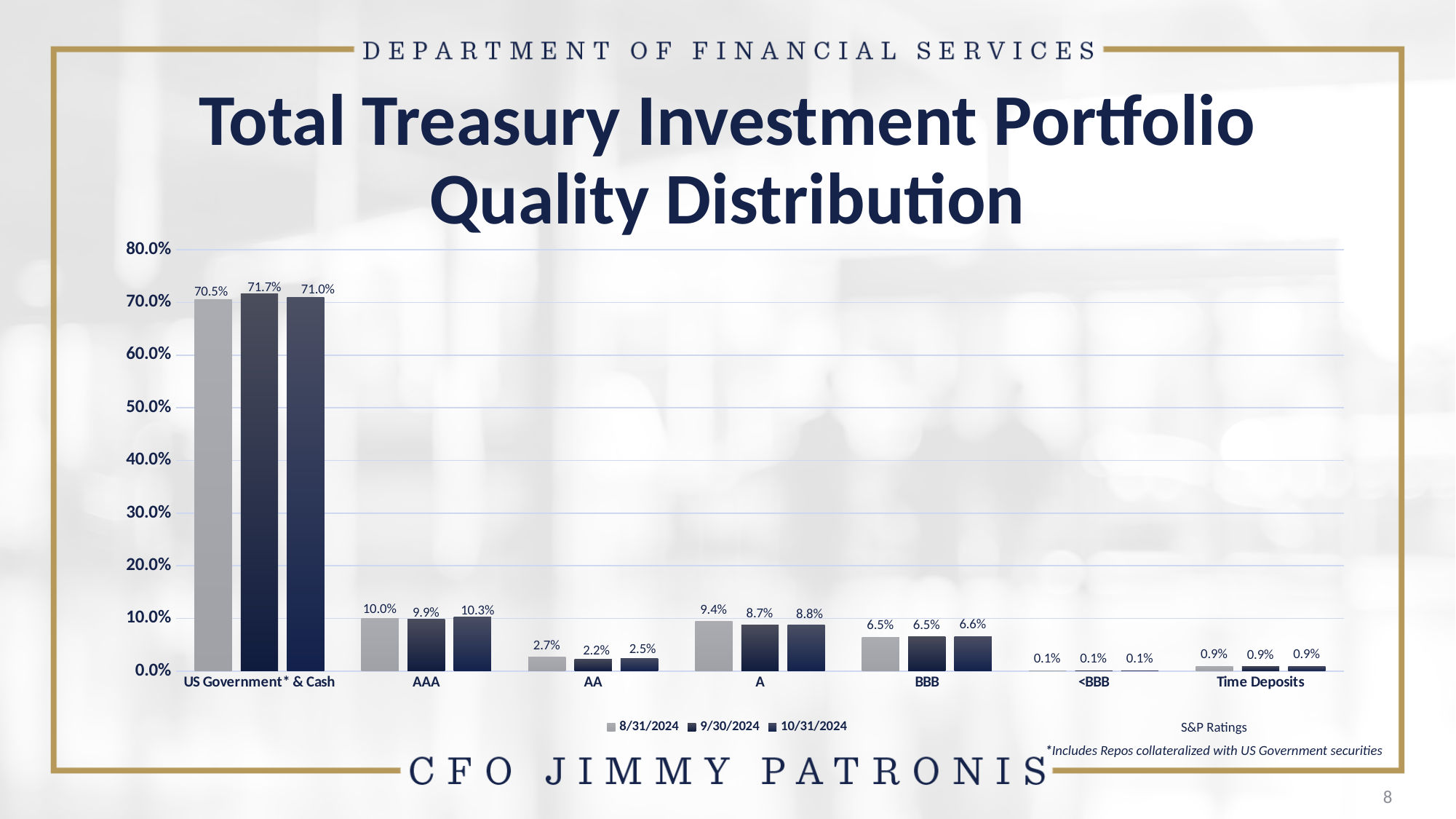
How many series does the legend list? 3 What is the value for AA in the 8/31/2024 series? 2.7% Which is larger: the 8/31/2024 value for A or the 8/31/2024 value for BBB? A Which category has the lowest value in the 10/31/2024 series? <BBB What is the value for US Government* & Cash in the 9/30/2024 series? 71.7% What kind of chart is shown on the slide? Bar chart Which category has the highest value in the 8/31/2024 series? US Government* & Cash What is the title of the chart? Total Treasury Investment Portfolio Quality Distribution How many categories are shown on the x axis? 7 What is the difference between the 10/31/2024 and 8/31/2024 values for US Government* & Cash? 0.5% What is the value for AAA in the 10/31/2024 series? 10.3% What is the value for A in the 9/30/2024 series? 8.7%